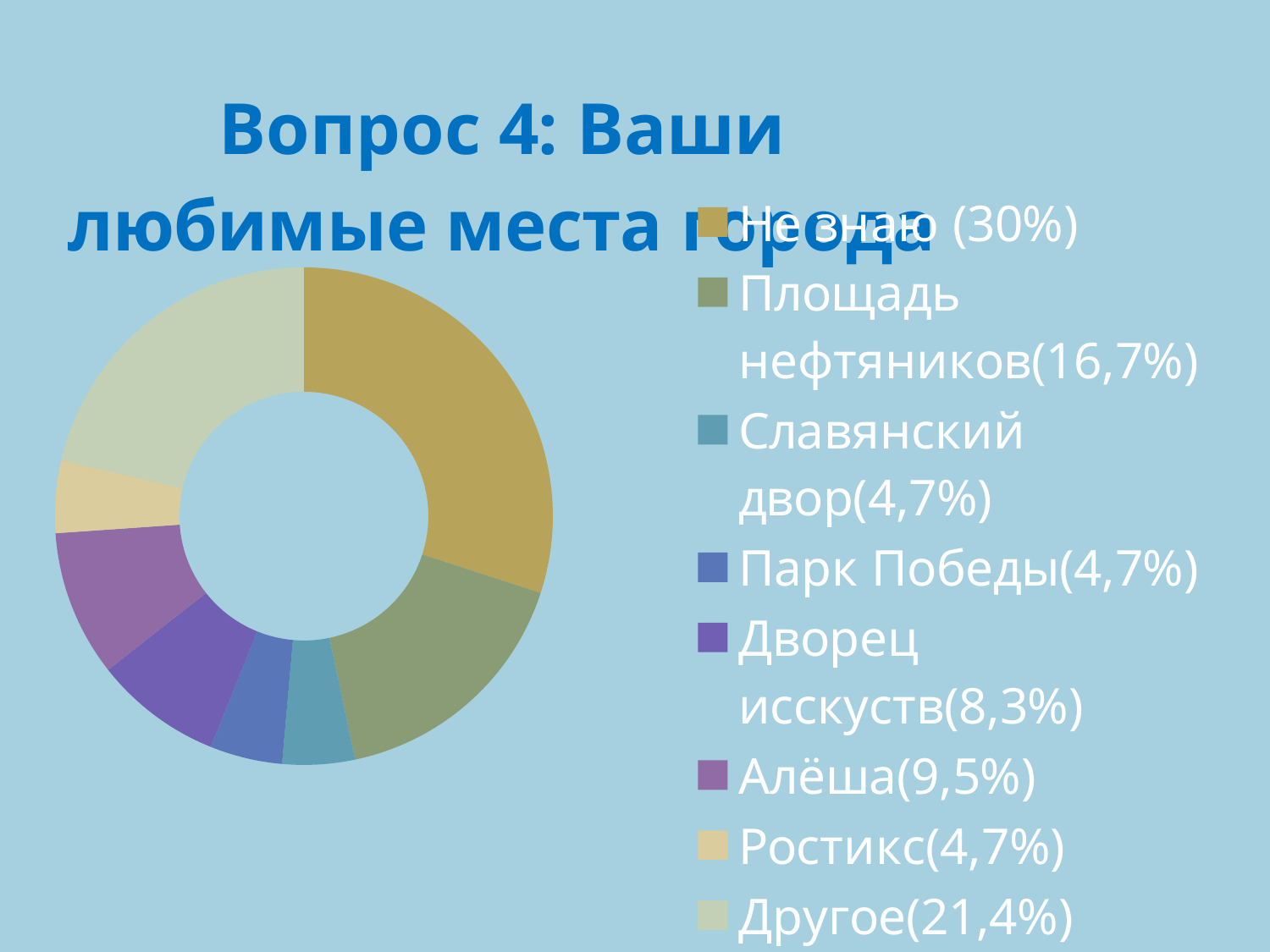
What is the title of the chart on the slide? Вопрос 4: Ваши любимые места города What percentage is shown for "Дворец исскуств"? 8,3% What percentage is shown for "Алёша"? 9,5% Which category has the largest share of the chart? Не знаю Which categories share the same percentage of 4,7%? Славянский двор, Парк Победы, Ростикс What share of the chart does "Не знаю" have? 30% Which has a larger share, "Алёша" or "Дворец исскуств"? Алёша How many categories does the chart show? 8 What kind of chart is shown on the slide? doughnut chart What is the difference in percentage points between "Не знаю" and "Другое"? 8,6 What percentage is shown for "Площадь нефтяников"? 16,7% What percentage is shown for "Другое"? 21,4%